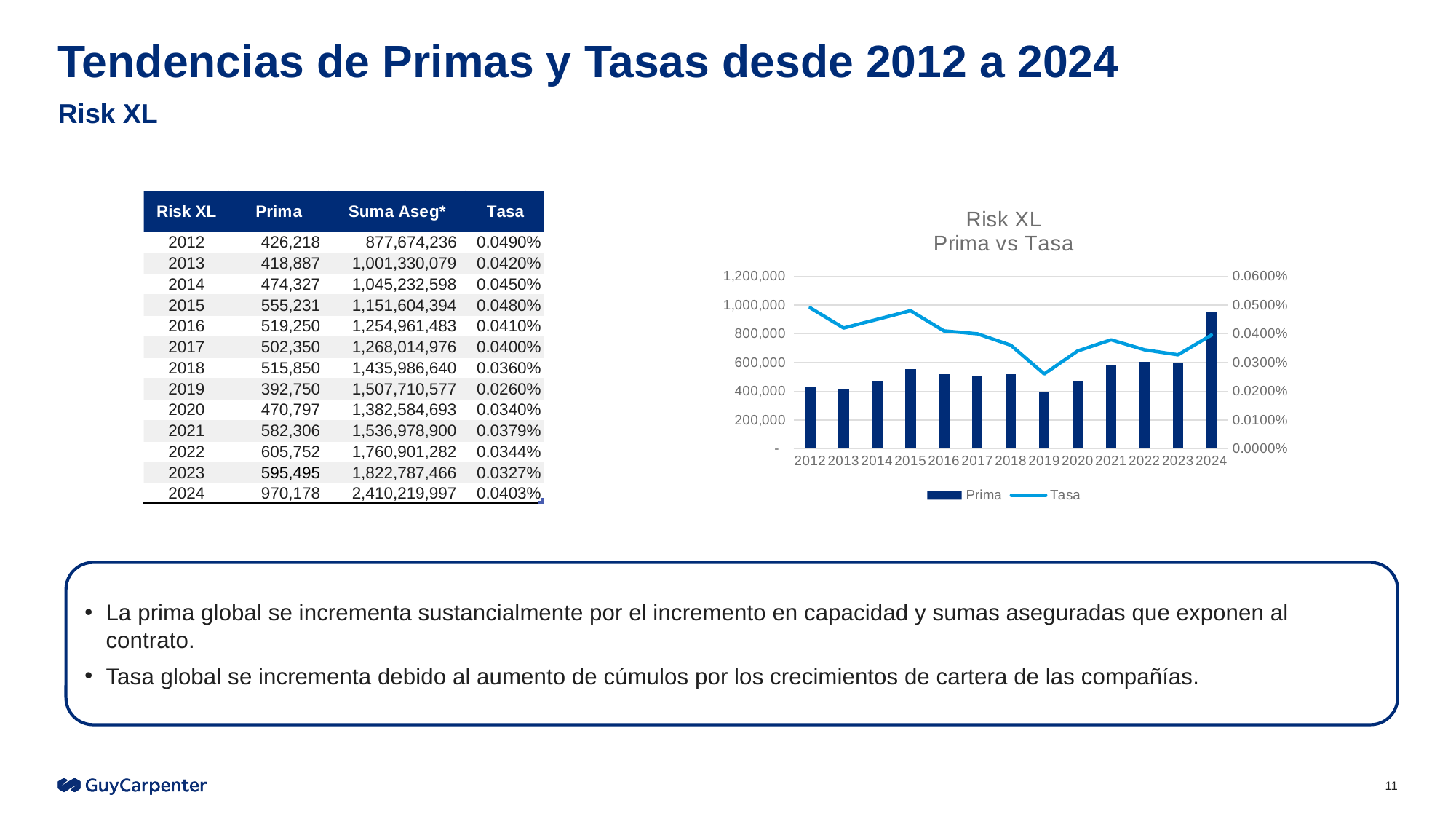
How many series does the legend of the "Risk XL Prima vs Tasa" chart list? 2 How many years are shown on the x axis of the "Risk XL Prima vs Tasa" chart? 13 Using the Risk XL table, what is the difference between the Prima for 2024 and the Prima for 2023? 374,683 In the "Risk XL Prima vs Tasa" chart, is the Tasa value for 2019 greater or less than 0.0300%? less According to the Risk XL table, what is the Prima value for 2024? 970,178 In the "Risk XL Prima vs Tasa" chart, which year has the highest Prima bar? 2024 According to the Risk XL table, what is the Tasa value for 2019? 0.0260% In the "Risk XL Prima vs Tasa" chart, which year has the lowest Tasa value? 2019 In the "Risk XL Prima vs Tasa" chart, is the Prima value for 2024 greater or less than 800,000? greater In the "Risk XL Prima vs Tasa" chart, does the Tasa line rise or fall from 2012 to 2019? fall What kind of chart is the "Risk XL Prima vs Tasa" chart? A bar chart combined with a line chart In the "Risk XL Prima vs Tasa" chart, which year has the lowest Prima bar? 2019